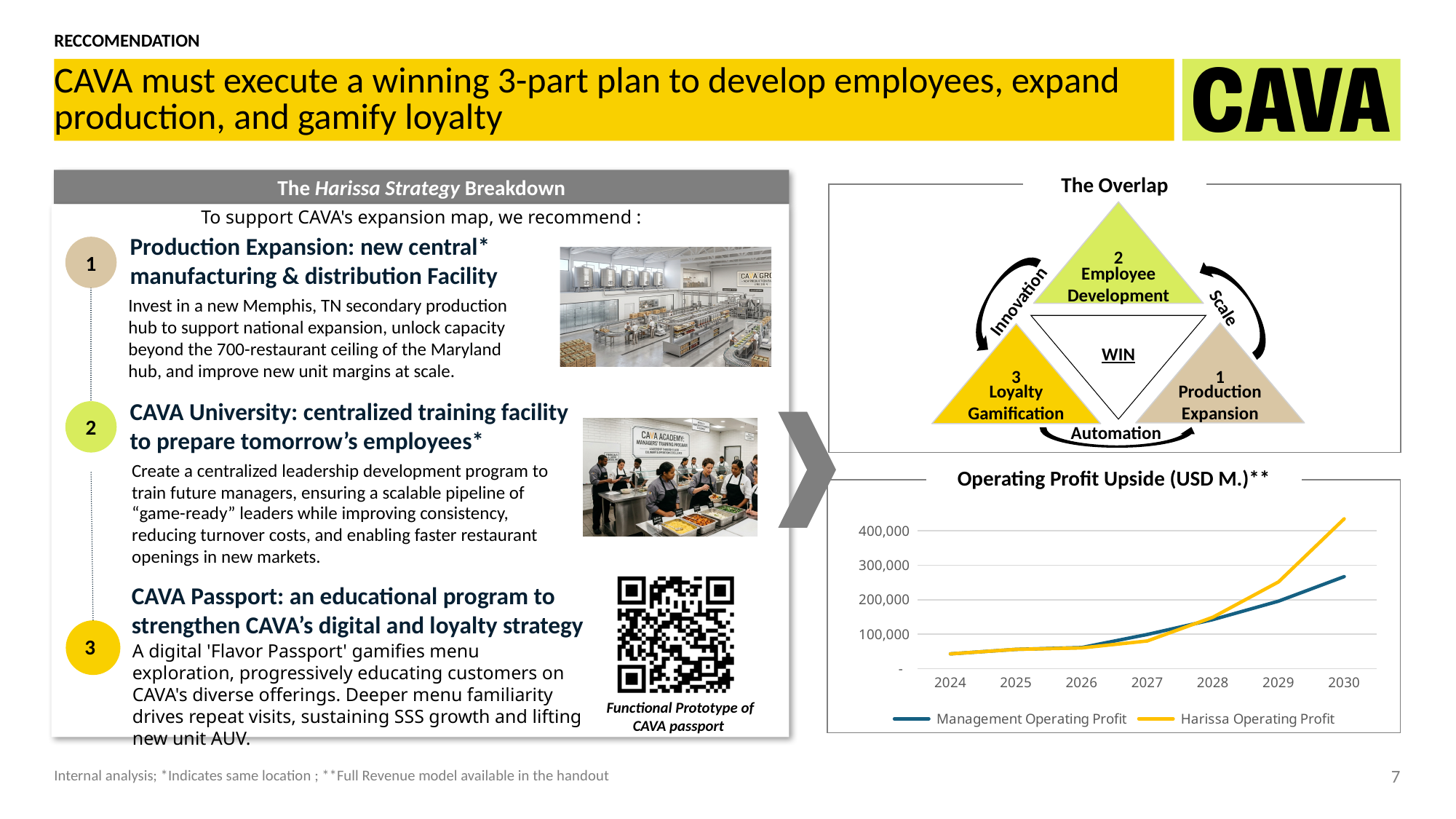
In the "Operating Profit Upside (USD M.)" chart, which year has the highest Harissa Operating Profit value? 2030 What is the title of the line chart on the slide? Operating Profit Upside (USD M.)** In the "Operating Profit Upside (USD M.)" chart, does the Harissa Operating Profit line rise or fall from 2024 to 2030? rise In the "Operating Profit Upside (USD M.)" chart, which series is drawn in yellow? Harissa Operating Profit How many series does the legend of the "Operating Profit Upside (USD M.)" chart list? 2 In the "Operating Profit Upside (USD M.)" chart, which series has the higher value in 2030, Management Operating Profit or Harissa Operating Profit? Harissa Operating Profit How many years are plotted on the x axis of the "Operating Profit Upside (USD M.)" chart? 7 In the "Operating Profit Upside (USD M.)" chart, is the Harissa Operating Profit value for 2030 greater or less than 400,000? greater In the "Operating Profit Upside (USD M.)" chart, is the Management Operating Profit value for 2030 greater or less than 300,000? less In the "Operating Profit Upside (USD M.)" chart, is the Harissa Operating Profit value for 2029 greater or less than 200,000? greater What kind of chart is the "Operating Profit Upside (USD M.)" chart? line chart